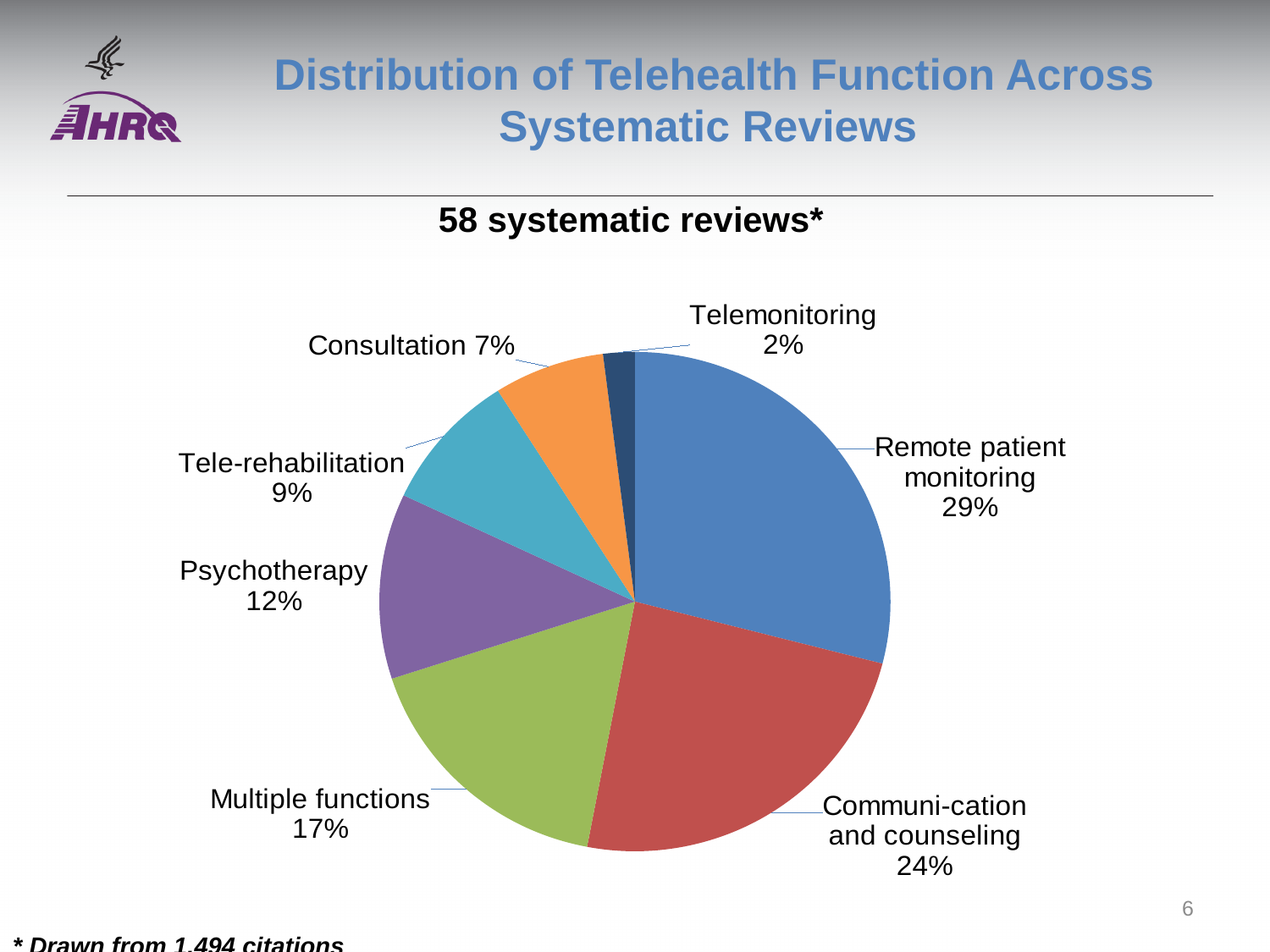
What is the value shown for Psychotherapy? 12% Which is larger, Consultation or Tele-rehabilitation? Tele-rehabilitation What is the title of the chart? Distribution of Telehealth Function Across Systematic Reviews What is the combined share of Psychotherapy and Multiple functions? 29% What is the difference in percentage points between Remote patient monitoring and Communi-cation and counseling? 5% How many categories are shown in the pie chart? 7 Which category has the largest slice of the pie? Remote patient monitoring What share of the pie does Remote patient monitoring represent? 29% What is the value shown for Multiple functions? 17% Which category has the smallest slice of the pie? Telemonitoring What kind of chart is shown on the slide? pie chart What is the value shown for Tele-rehabilitation? 9%